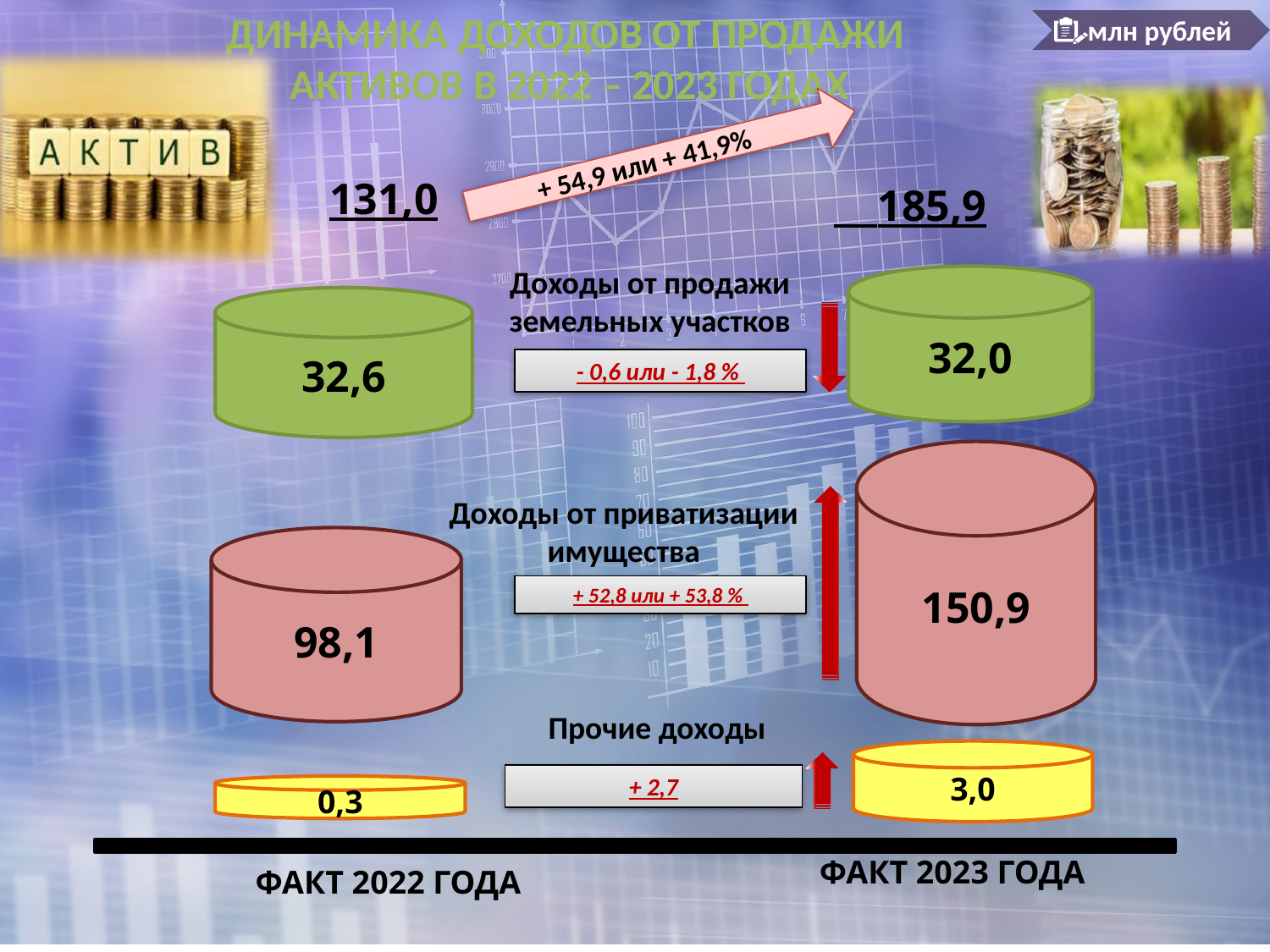
Каков доход от приватизации имущества по факту 2023 года? 150,9 На сколько процентов выросла общая сумма доходов от продажи активов с 2022 по 2023 год? + 41,9% Сколько категорий доходов показано на слайде? 3 Что больше: доход от продажи земельных участков в 2022 году или в 2023 году? в 2022 году Каков доход от продажи земельных участков по факту 2022 года? 32,6 Какая категория доходов имеет наибольшее значение по факту 2023 года? Доходы от приватизации имущества В каких единицах измерения приведены значения на слайде? млн рублей На сколько доход от приватизации имущества в 2023 году больше, чем в 2022 году? 52,8 На сколько изменился доход от продажи земельных участков с 2022 по 2023 год? - 0,6 Каковы прочие доходы по факту 2022 года? 0,3 Какая категория доходов имеет наименьшее значение по факту 2022 года? Прочие доходы Какова общая сумма доходов от продажи активов по факту 2023 года? 185,9